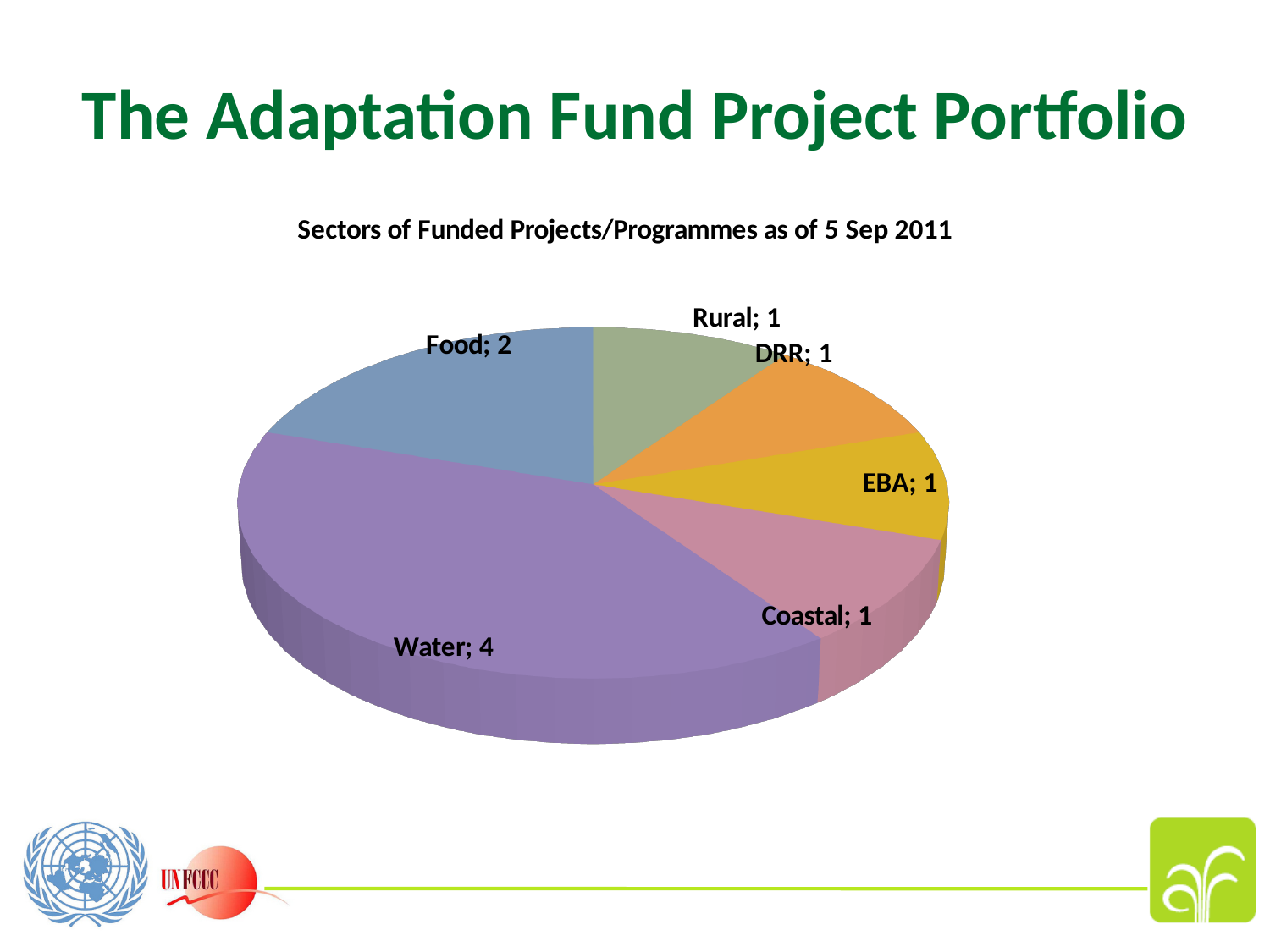
How many projects/programmes are in the Food sector? 2 What kind of chart is shown on the slide? pie chart Which sector has the largest number of funded projects/programmes? Water What share of the funded projects/programmes is in the Food sector? 20% How many projects/programmes are in the Water sector? 4 What share of the funded projects/programmes is in the Water sector? 40% How many sectors are shown in the pie chart? 6 How many projects/programmes are in the Coastal sector? 1 What is the total number of funded projects/programmes across all sectors? 10 Which has more funded projects/programmes, Food or EBA? Food What is the difference between the number of Water projects and the number of Food projects? 2 What is the title of the chart? Sectors of Funded Projects/Programmes as of 5 Sep 2011